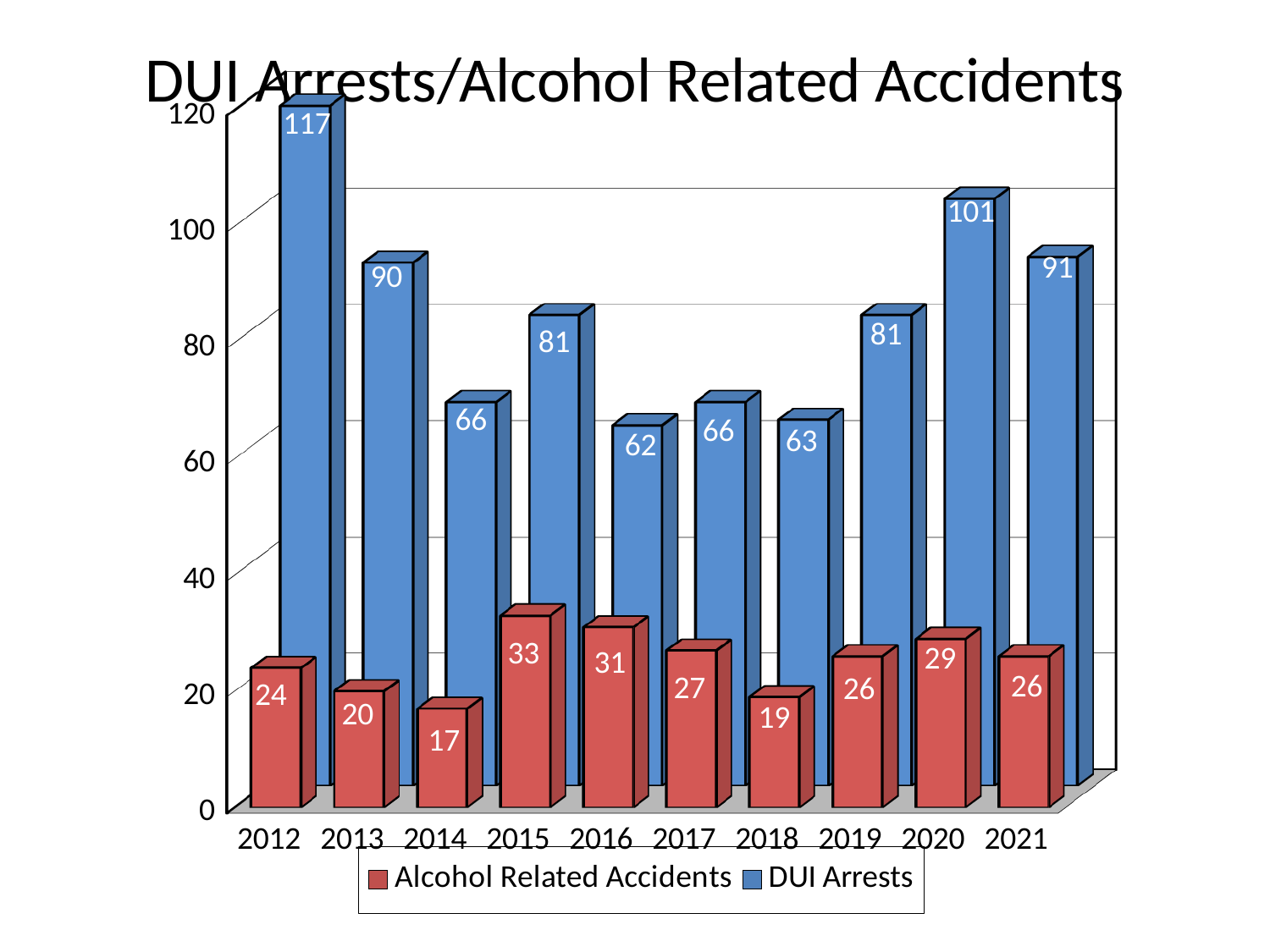
What is the value for DUI Arrests in 2012? 117 What kind of chart is shown on the slide? Bar chart What is the title of the chart? DUI Arrests/Alcohol Related Accidents Which year has the highest value for DUI Arrests? 2012 What is the difference between DUI Arrests in 2013 and DUI Arrests in 2014? 24 Which is larger: DUI Arrests in 2019 or DUI Arrests in 2021? DUI Arrests in 2021 What is the value for Alcohol Related Accidents in 2015? 33 Which colour represents DUI Arrests in the chart? Blue Which year has the lowest value for Alcohol Related Accidents? 2014 How many series does the legend list? 2 How many years are shown on the x axis? 10 What is the value for DUI Arrests in 2020? 101